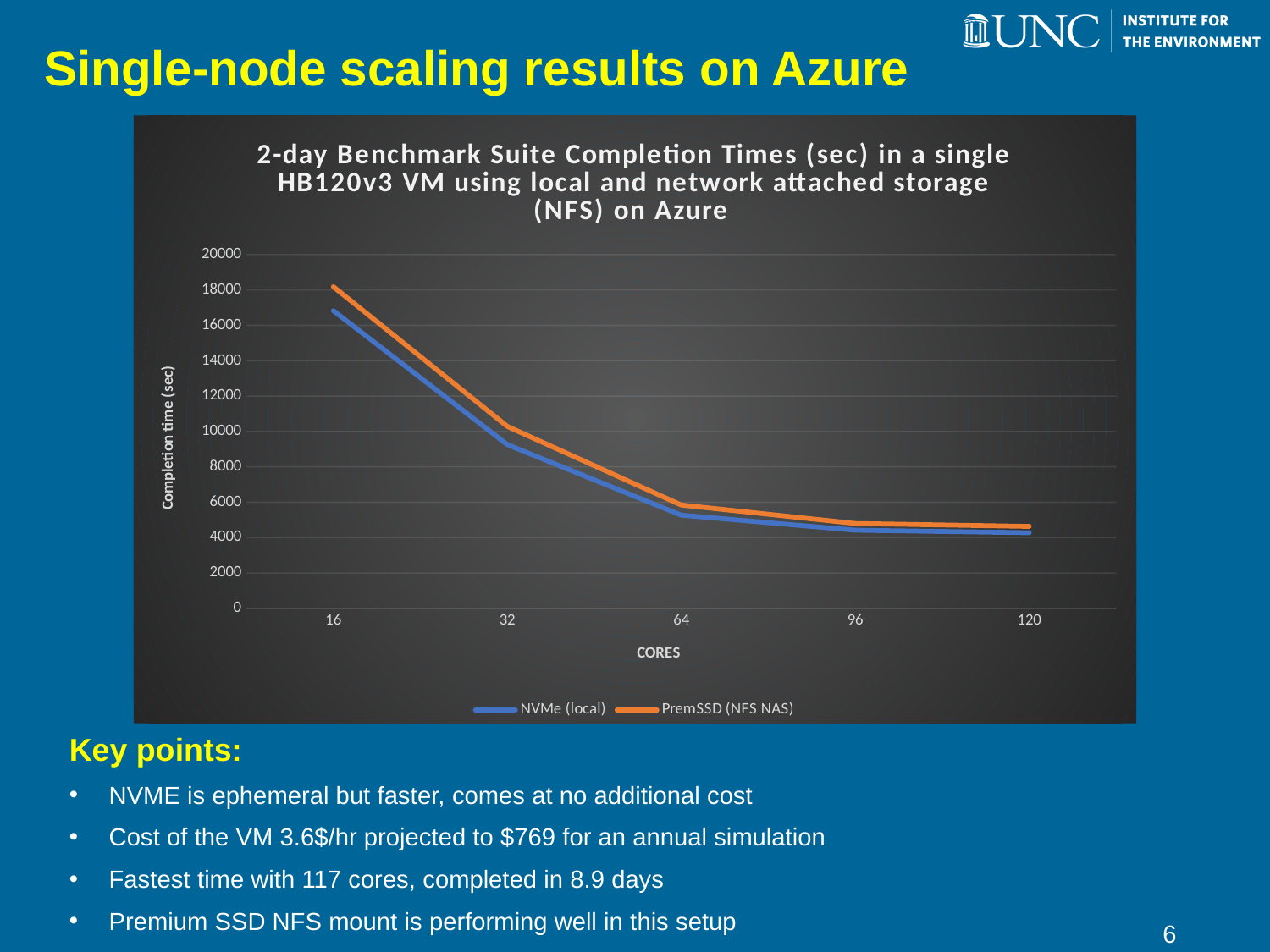
At 16 cores, which series has the higher completion time, NVMe (local) or PremSSD (NFS NAS)? PremSSD (NFS NAS) Is the NVMe (local) completion time at 16 cores greater or less than 16000? greater Do the completion times rise or fall as the number of cores increases? fall How many core counts are plotted along the x axis? 5 What is the label of the y axis? Completion time (sec) Is the NVMe (local) completion time at 32 cores greater or less than 10000? less For the NVMe (local) series, at which core count is the completion time highest? 16 Is the PremSSD (NFS NAS) completion time at 16 cores greater or less than 20000? less How many series does the chart legend list? 2 What is the label of the x axis? CORES What kind of chart is shown on the slide? line chart